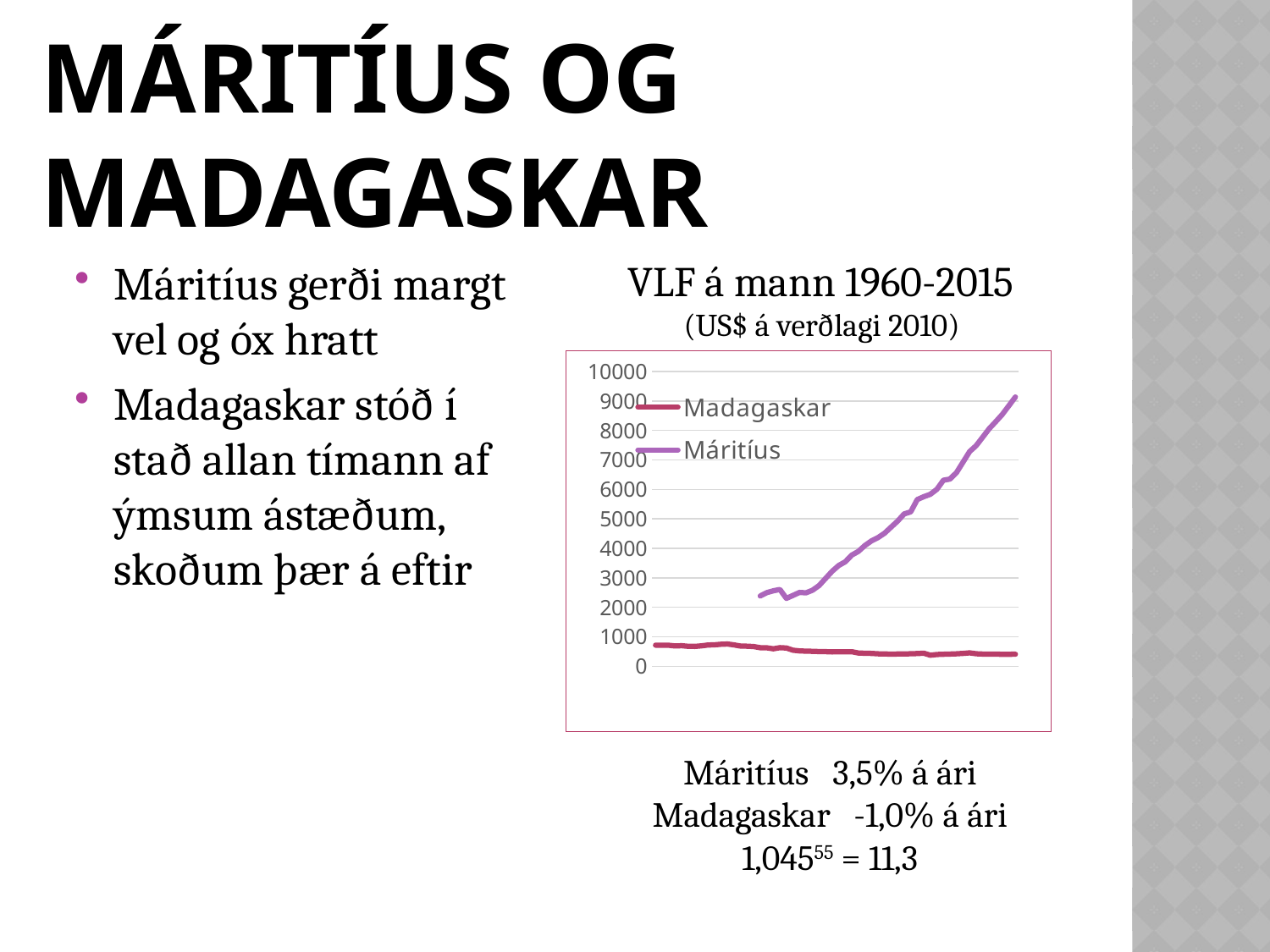
What are the two series named in the chart legend? Madagaskar and Máritíus Does the Madagaskar line rise or fall over the period shown? falls Is the starting value of the Máritíus line greater or less than 2000? greater What kind of chart is shown on the slide? line chart Does the Máritíus line rise or fall over the period shown? rises Which series reaches the highest value on the chart? Máritíus Is the final value of the Máritíus line greater or less than 8000? greater What is the title of the chart? VLF á mann 1960-2015 (US$ á verðlagi 2010) Which series has the lowest values on the chart? Madagaskar Is the value of the Madagaskar line at the end of the period greater or less than 1000? less At the end of the period, which series is higher, Máritíus or Madagaskar? Máritíus How many series does the chart legend list? 2